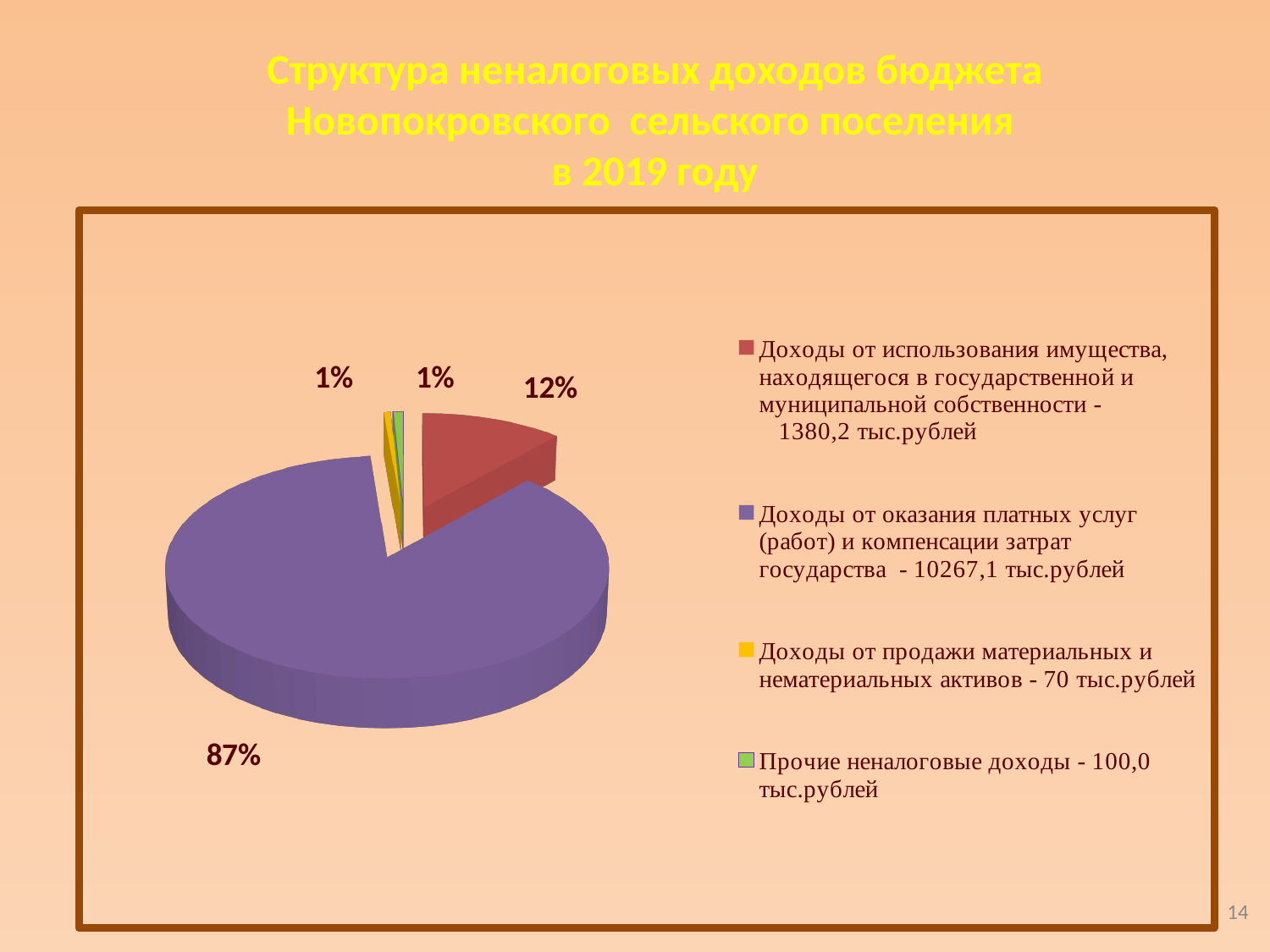
What share of the pie is labelled for 'Прочие неналоговые доходы'? 1% What share of the pie is labelled for 'Доходы от использования имущества, находящегося в государственной и муниципальной собственности'? 12% Which is larger: the share for 'Доходы от использования имущества' or the share for 'Прочие неналоговые доходы'? Доходы от использования имущества What is the difference in percentage points between the 87% slice and the 12% slice? 75 According to the legend, what is the amount for 'Доходы от продажи материальных и нематериальных активов'? 70 тыс.рублей What share of the pie is labelled for 'Доходы от оказания платных услуг (работ) и компенсации затрат государства'? 87% What kind of chart is shown on the slide? pie chart According to the legend, what is the amount for 'Прочие неналоговые доходы'? 100,0 тыс.рублей How many entries does the legend list? 4 How many slices does the pie chart have? 4 Which category has the largest slice of the pie? Доходы от оказания платных услуг (работ) и компенсации затрат государства According to the legend, what is the amount for 'Доходы от оказания платных услуг (работ) и компенсации затрат государства'? 10267,1 тыс.рублей